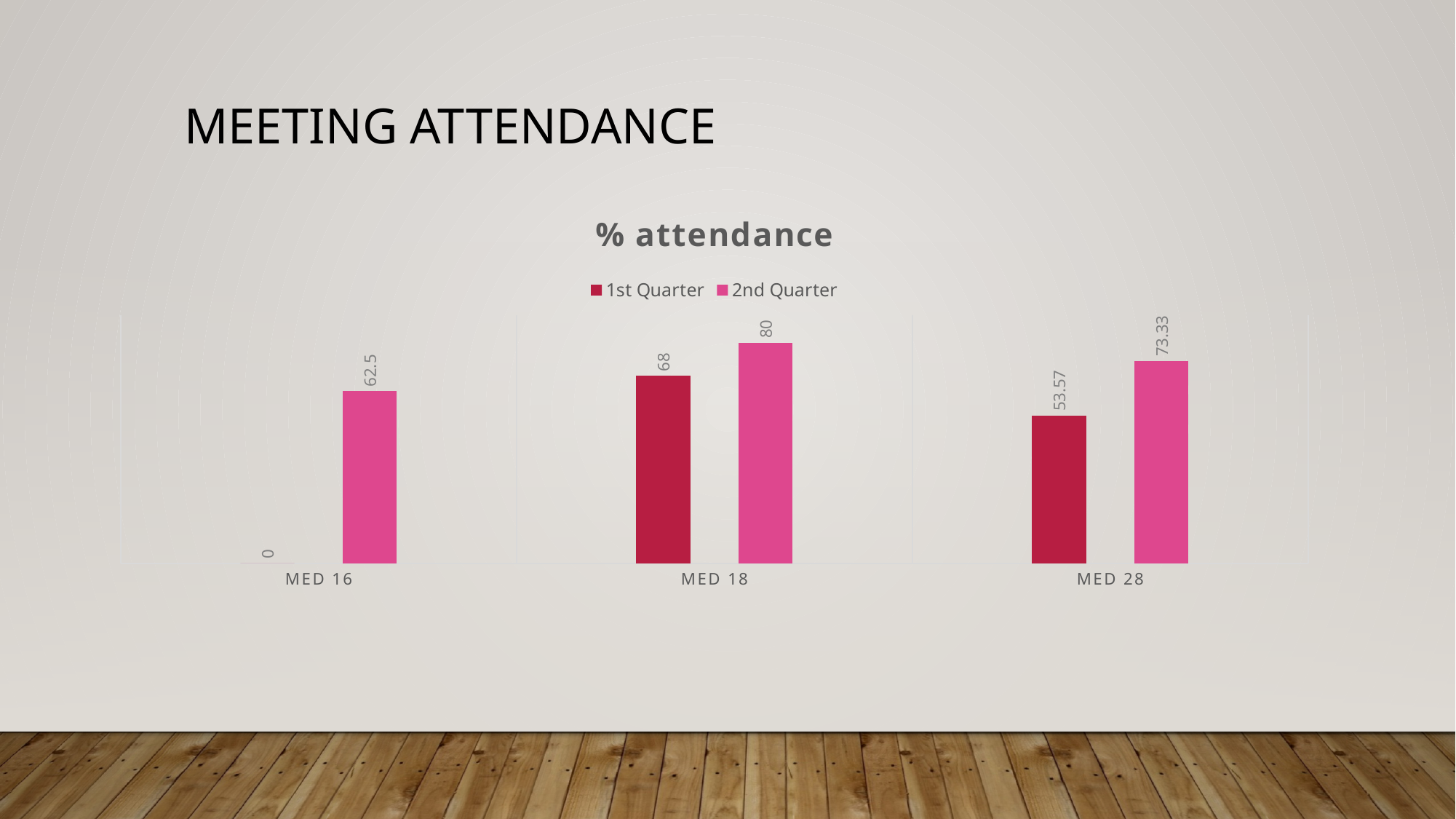
What is the 2nd Quarter value for MED 16? 62.5 What is the title of the chart? % attendance What is the 1st Quarter value for MED 18? 68 Which category has the highest 2nd Quarter value? MED 18 What kind of chart is shown on the slide? Bar chart Which is larger for MED 28, the 1st Quarter value or the 2nd Quarter value? 2nd Quarter How many series does the legend list? 2 How many categories are shown on the x axis? 3 What is the 2nd Quarter value for MED 28? 73.33 Which category has the lowest 1st Quarter value? MED 16 What is the 1st Quarter value for MED 16? 0 What is the difference between the 2nd Quarter and 1st Quarter values for MED 18? 12